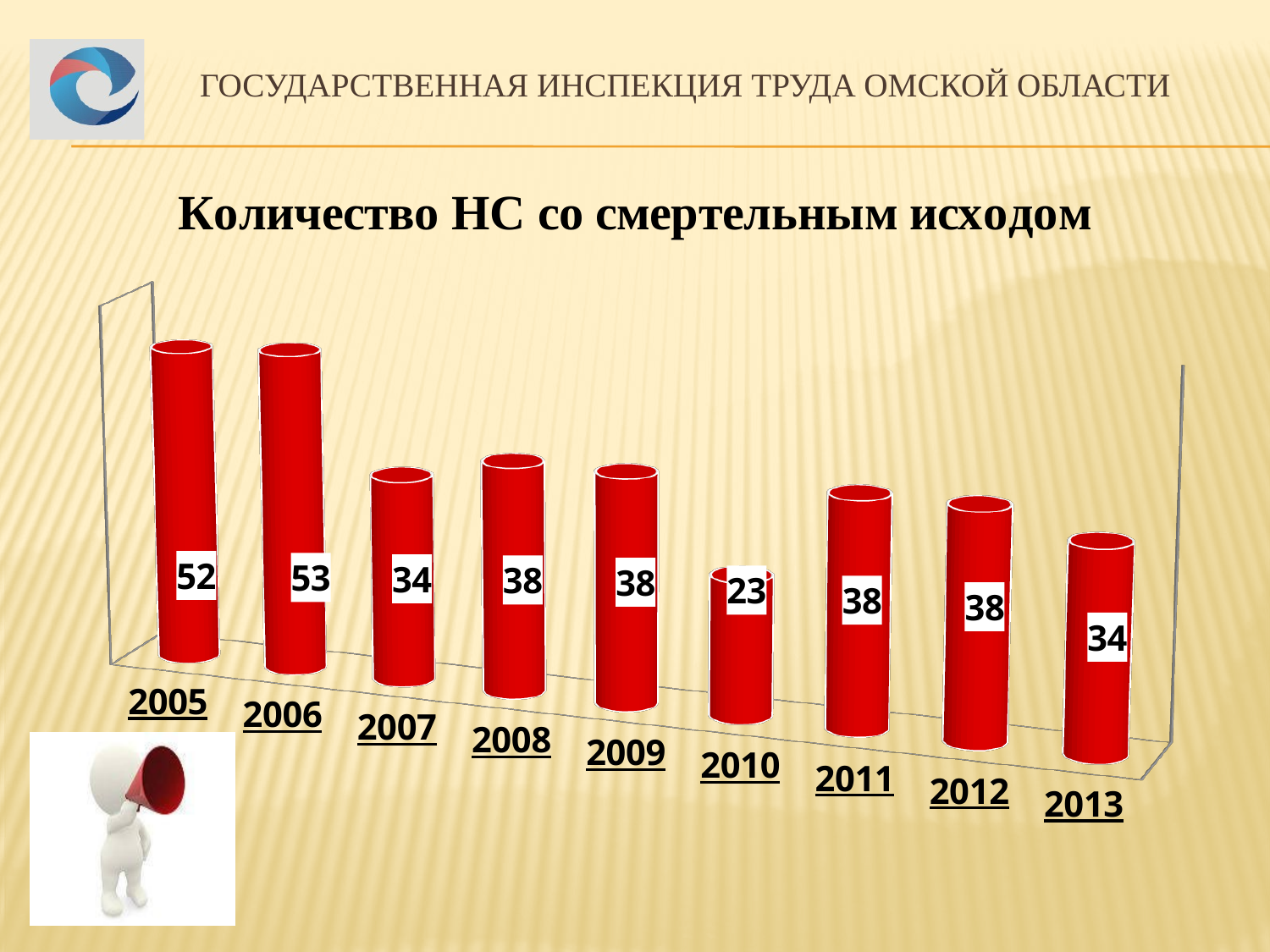
What is the value for 2005? 52 What is the difference between the values for 2005 and 2007? 18 What is the value for 2010? 23 Which year has the lowest value? 2010 What is the title of the chart? Количество НС со смертельным исходом What colour are the bars on the chart? red What is the difference between the values for 2006 and 2010? 30 What is the value for 2013? 34 Which year has the highest value? 2006 How many years are shown on the chart? 9 Which is larger, the value for 2007 or the value for 2008? 2008 What kind of chart is this? bar chart